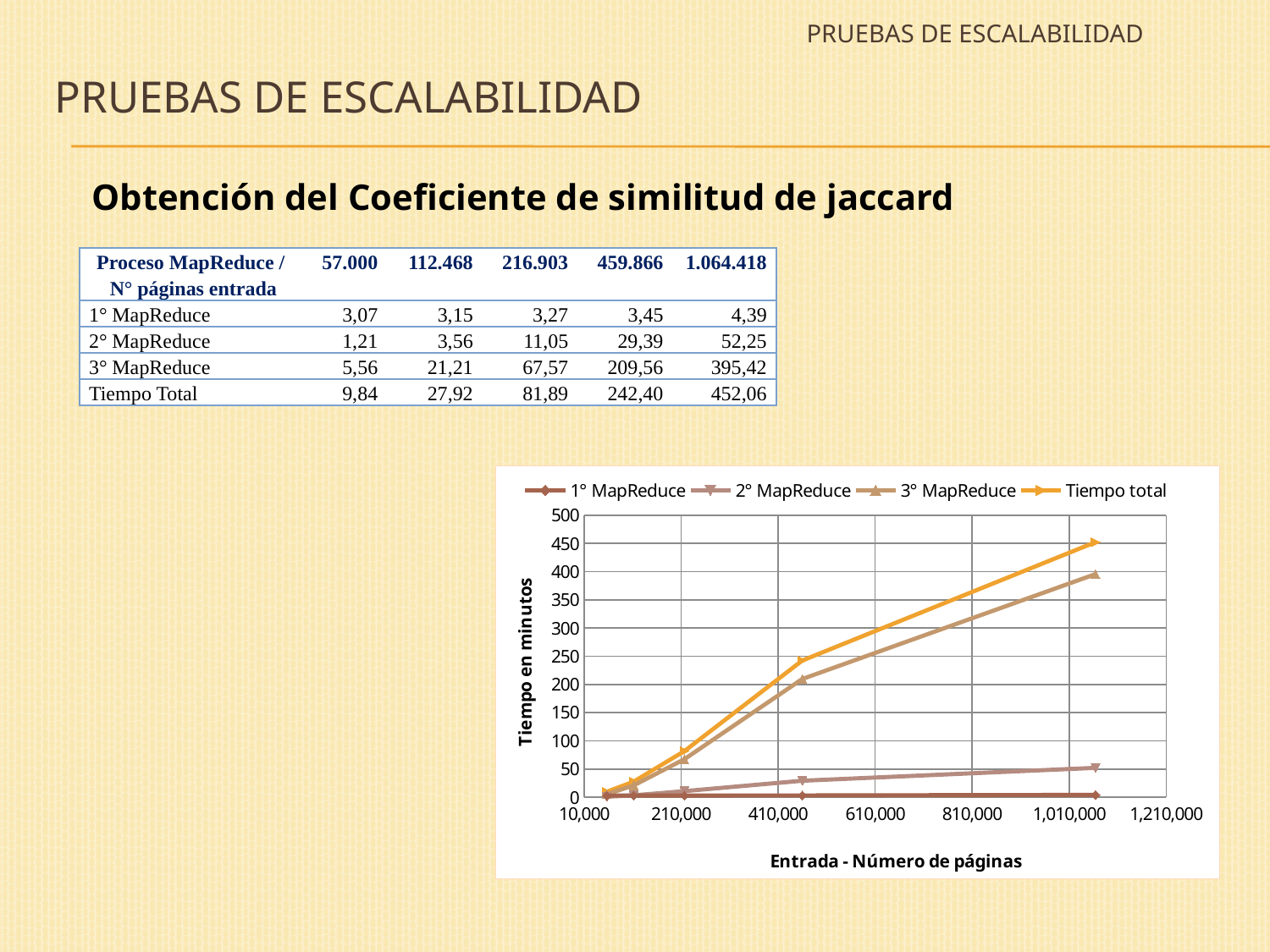
What is the title of the chart's vertical axis? Tiempo en minutos Is the value of Tiempo total at the largest input (about 1,064,418 pages) greater or less than 400? greater Using the table values, what is the difference between Tiempo Total and 3° MapReduce for 1.064.418 input pages? 56,64 How many data points does each series in the chart have? 5 Which series reaches the highest value at the largest number of input pages? Tiempo total Is the value of 3° MapReduce at about 459,866 pages greater or less than 250? less What is the title of the chart's horizontal axis? Entrada - Número de páginas Does the Tiempo total series rise or fall as the number of input pages increases? rise How many series does the chart legend list? 4 According to the table, what is the Tiempo Total for 1.064.418 input pages? 452,06 What kind of chart is shown on the slide? line chart